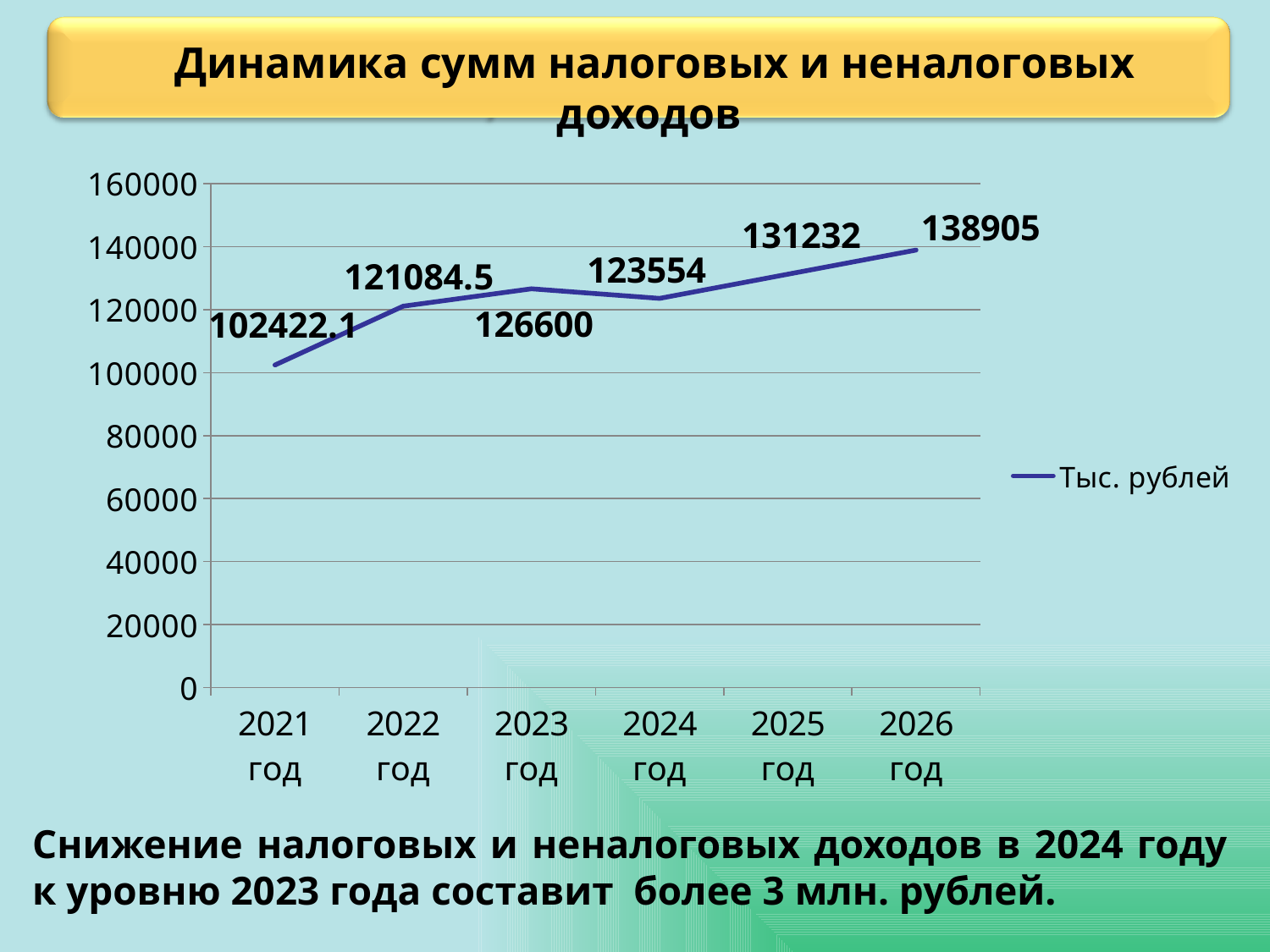
What is the difference between the values for 2023 год and 2024 год? 3046 Which is larger, the value for 2023 год or the value for 2024 год? 2023 год What type of chart is shown on the slide? line chart What is the legend entry for the plotted series? Тыс. рублей Which year has the lowest value? 2021 год How many years are plotted on the x axis? 6 What is the value for 2026 год? 138905 What is the value for 2022 год? 121084.5 What is the difference between the values for 2026 год and 2025 год? 7673 What is the value for 2024 год? 123554 Which year has the highest value? 2026 год What is the value for 2021 год? 102422.1